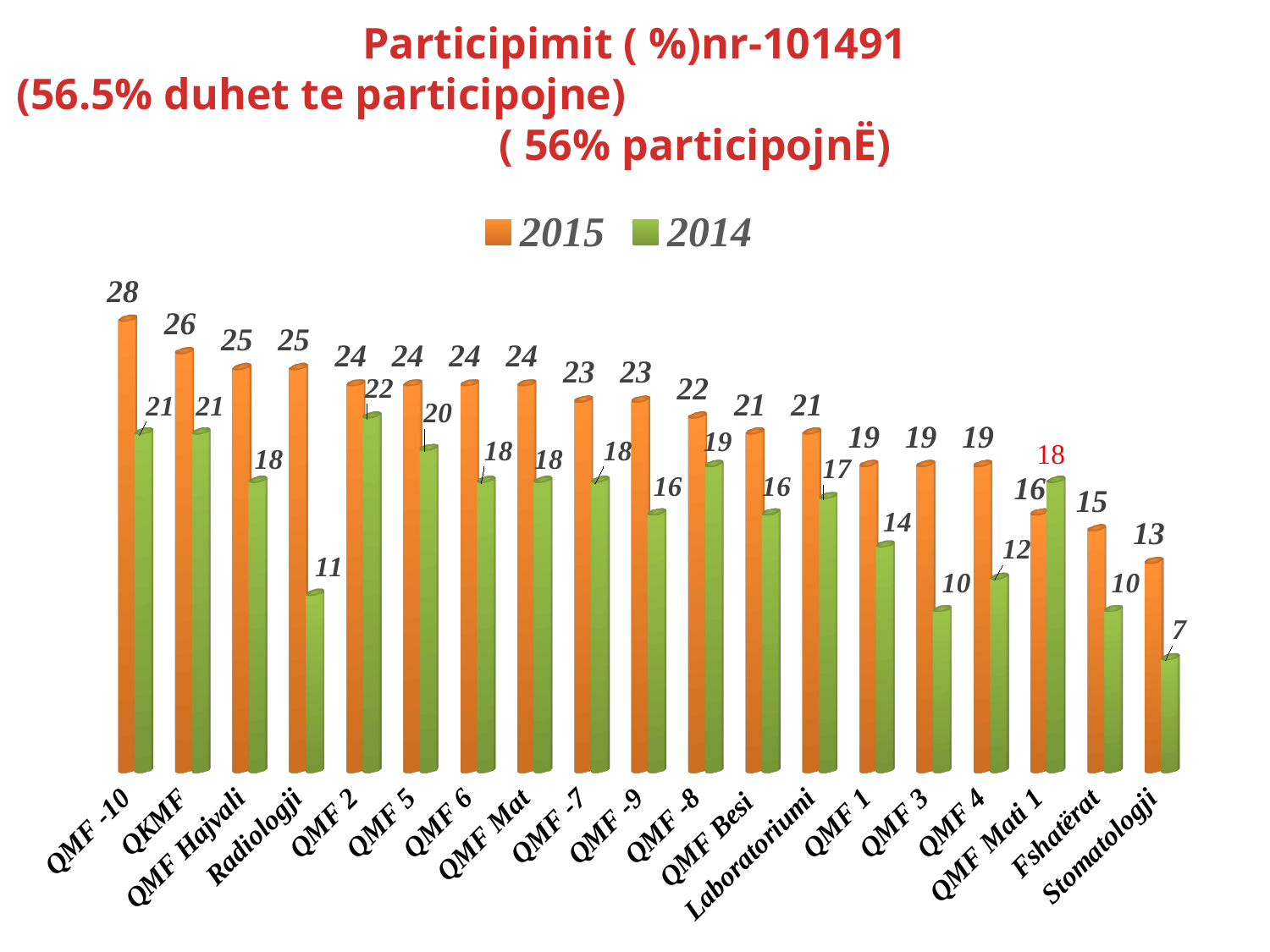
How many categories are shown on the x axis? 19 What is the 2014 value for QMF Mati 1? 18 What is the difference between the 2015 and 2014 values for Radiologji? 14 What is the 2015 value for QMF -10? 28 What kind of chart is shown on the slide? Bar chart Which colour represents the 2014 series in the legend? Green What is the 2015 value for Stomatologji? 13 For QMF Mati 1, which series has the larger value, 2015 or 2014? 2014 Which category has the highest 2015 value? QMF -10 What is the 2014 value for Radiologji? 11 Which category has the lowest 2014 value? Stomatologji How many series does the legend list? 2